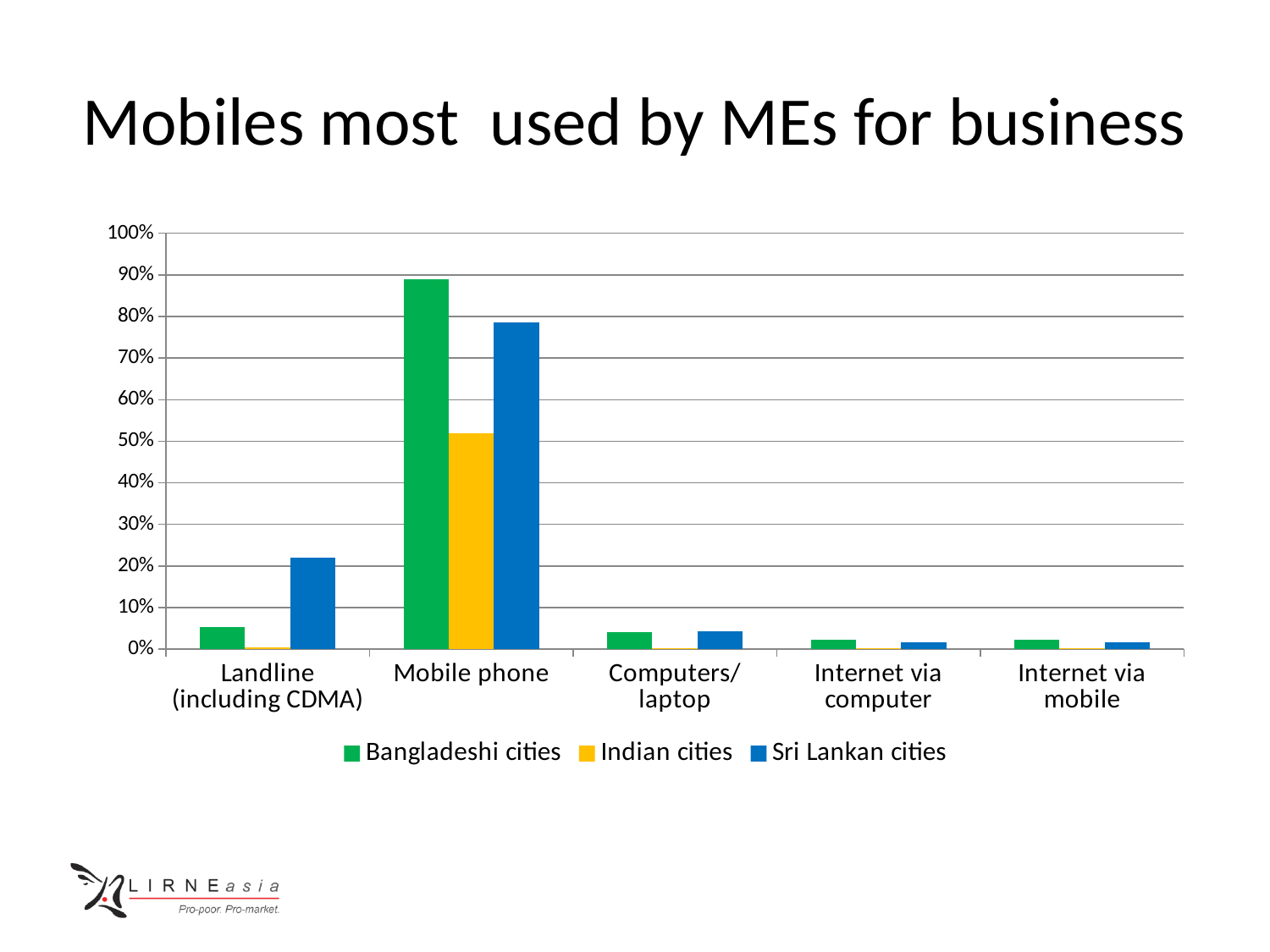
What is the title of the slide? Mobiles most used by MEs for business In the Landline (including CDMA) category, which is larger: the value for Sri Lankan cities or for Bangladeshi cities? Sri Lankan cities Is the value for Indian cities in the Mobile phone category greater or less than 60%? less Is the value for Sri Lankan cities in the Mobile phone category greater or less than 70%? greater What kind of chart is shown on the slide? Bar chart Is the value for Bangladeshi cities in the Mobile phone category greater or less than 80%? greater Which series has the lowest value in the Mobile phone category? Indian cities How many series does the chart's legend list? 3 Which category has the highest value for Bangladeshi cities? Mobile phone How many categories are shown on the x axis of the chart? 5 In the Mobile phone category, which is larger: the value for Bangladeshi cities or for Sri Lankan cities? Bangladeshi cities